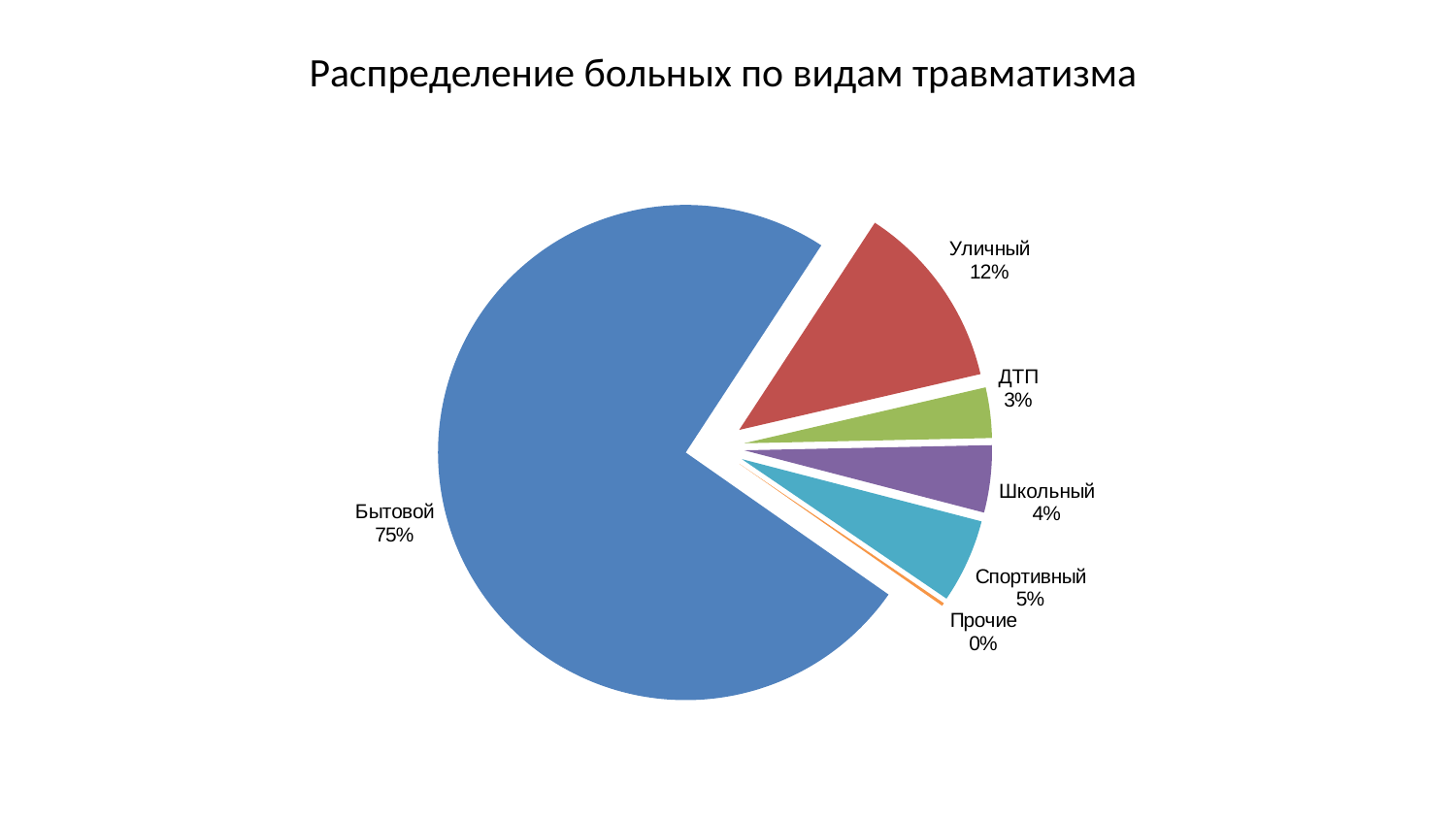
Which category has the largest share? Бытовой Which is larger, Спортивный or Школьный? Спортивный How many categories are shown in the pie chart? 6 What is the difference in percentage points between Бытовой and Уличный? 63 What kind of chart is shown on the slide? pie chart What is the share for Школьный? 4% What is the share for Спортивный? 5% What is the share for Уличный? 12% What is the share for Бытовой? 75% What is the share for ДТП? 3% What is the share for Прочие? 0% Which category has the smallest share? Прочие